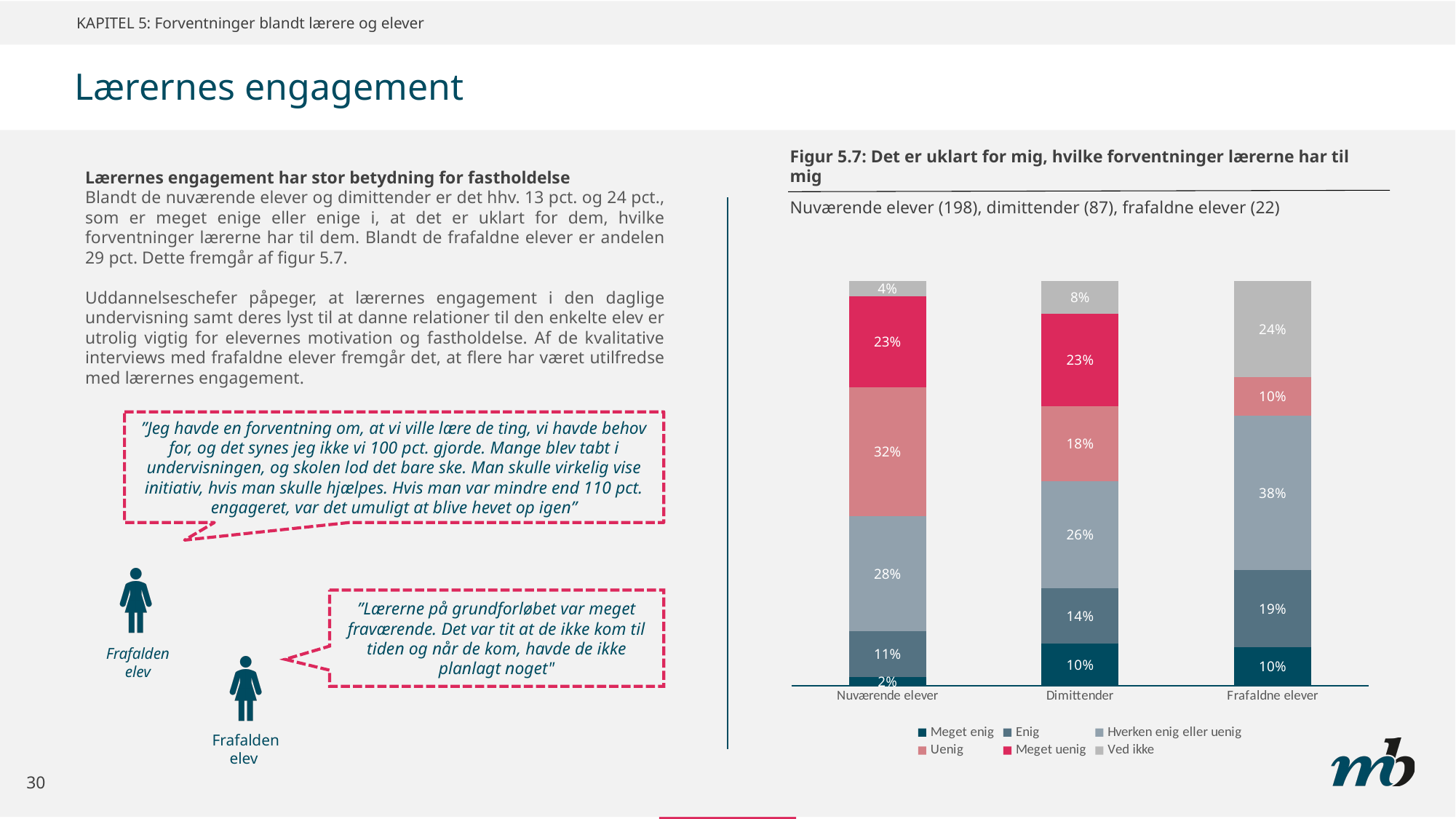
What is the value for 'Uenig' among Nuværende elever? 32% What kind of chart is shown in Figur 5.7? Stacked bar chart What is the value for 'Hverken enig eller uenig' among Frafaldne elever? 38% Which is larger: 'Hverken enig eller uenig' for Dimittender or for Frafaldne elever? Frafaldne elever Which category has the lowest value for 'Enig'? Nuværende elever How many series does the legend list? 6 How many categories are shown on the x axis of the chart? 3 What is the difference between the 'Uenig' values for Nuværende elever and Dimittender? 14 percentage points What is the value for 'Meget enig' among Nuværende elever? 2% Which series is shown in the darkest teal colour at the bottom of each bar? Meget enig Which category has the highest value for 'Ved ikke'? Frafaldne elever What is the value for 'Ved ikke' among Dimittender? 8%